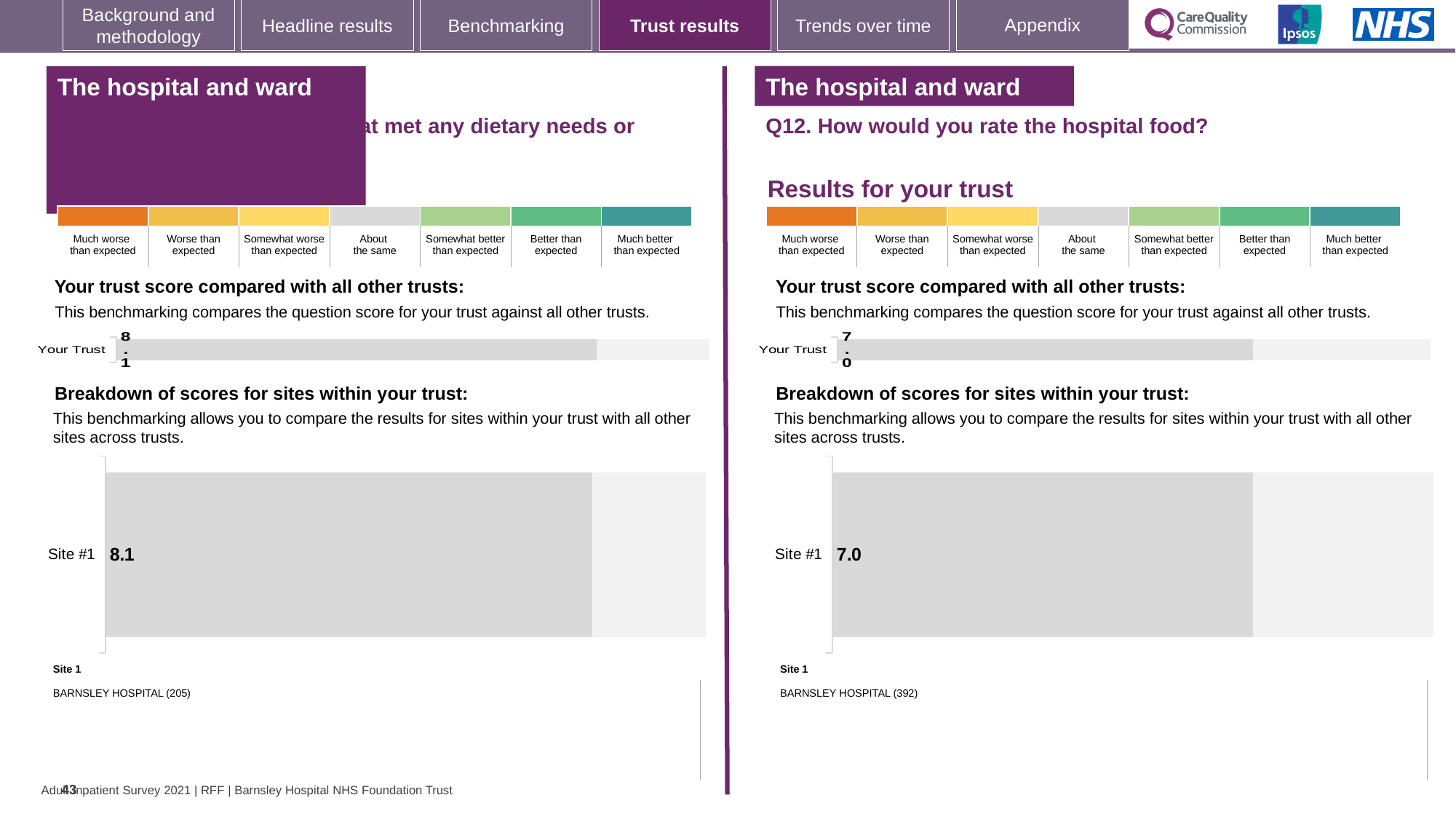
On the right-hand side of the slide (Q12. How would you rate the hospital food?), what score is shown for Site #1 in the 'Breakdown of scores for sites within your trust' chart? 7.0 Which site is listed as Site 1 beneath the breakdown chart on the right-hand side of the slide (Q12)? BARNSLEY HOSPITAL (392) Which is larger: the Site #1 score in the left-hand breakdown chart or the Site #1 score in the right-hand breakdown chart (Q12)? Left-hand chart (8.1) Is the Your Trust score on the right-hand side of the slide (Q12) greater or less than 8? less How many sites are shown in the 'Breakdown of scores for sites within your trust' chart on the right-hand side of the slide (Q12)? 1 How many sites are shown in the 'Breakdown of scores for sites within your trust' chart on the left-hand side of the slide? 1 On the right-hand side of the slide (Q12. How would you rate the hospital food?), what is the score shown for Your Trust in the 'Your trust score compared with all other trusts' chart? 7.0 Which site is listed as Site 1 beneath the breakdown chart on the left-hand side of the slide? BARNSLEY HOSPITAL (205) On the left-hand side of the slide, what is the score shown for Your Trust in the 'Your trust score compared with all other trusts' chart? 8.1 What kind of chart is used to show the Site #1 score in the 'Breakdown of scores for sites within your trust' section on the right-hand side of the slide? Bar chart On the left-hand side of the slide, what score is shown for Site #1 in the 'Breakdown of scores for sites within your trust' chart? 8.1 What is the difference between the Your Trust score on the left-hand side of the slide (8.1) and the Your Trust score on the right-hand side (7.0)? 1.1